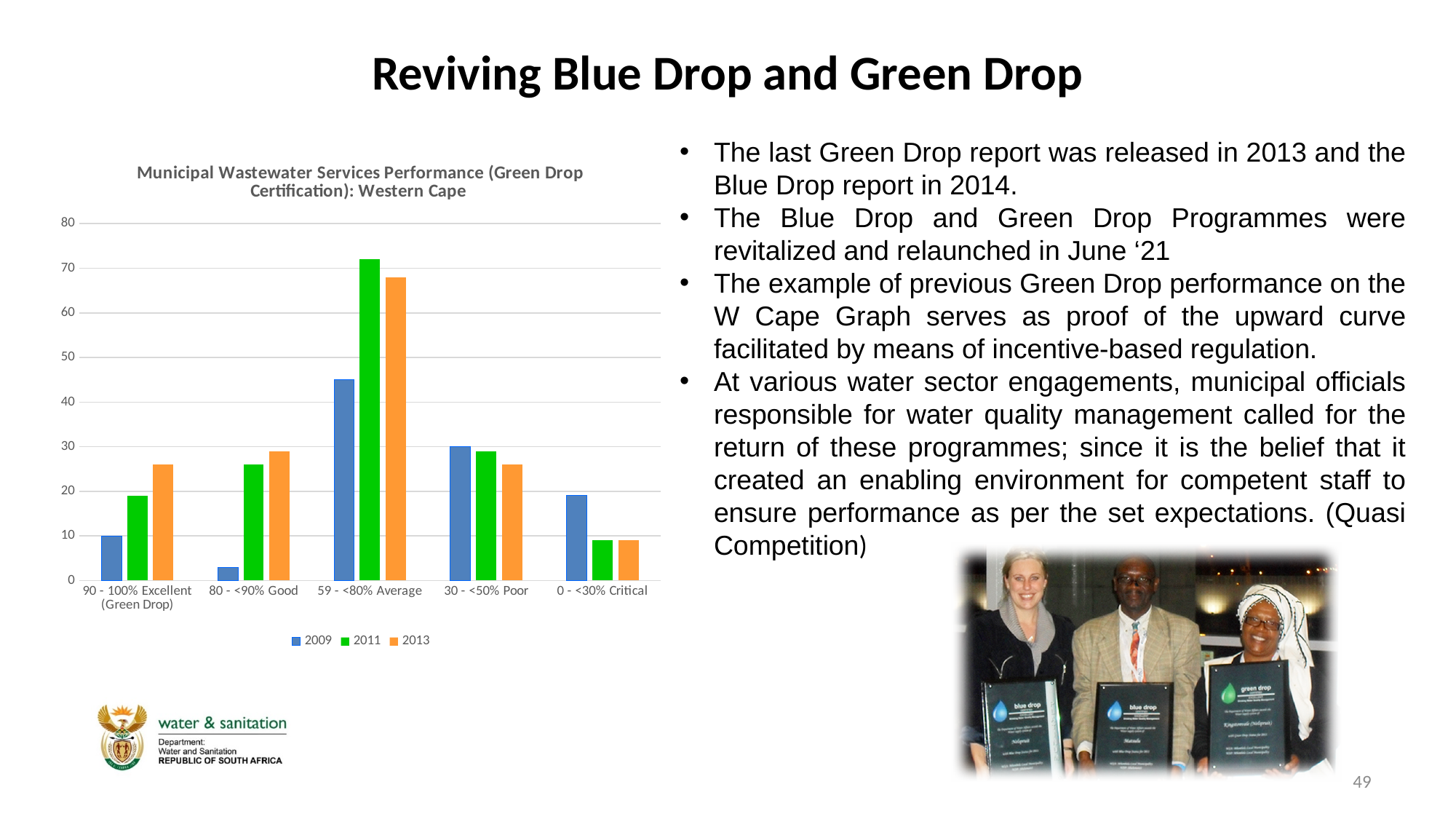
What is the title of the chart? Municipal Wastewater Services Performance (Green Drop Certification): Western Cape In the 90 - 100% Excellent (Green Drop) category, which is larger: the 2009 value or the 2013 value? 2013 Is the 2009 value for 59 - <80% Average greater or less than 40? greater Which series has the shortest bar in the 80 - <90% Good category? 2009 Is the 2011 value for 59 - <80% Average greater or less than 60? greater What kind of chart is shown on the slide? bar chart Do the values for the 80 - <90% Good category rise or fall from 2009 to 2013? rise How many performance categories are shown on the x axis? 5 How many series does the chart legend list? 3 Is the 2013 value for 90 - 100% Excellent (Green Drop) greater or less than 20? greater Which category has the tallest bar in the chart? 59 - <80% Average